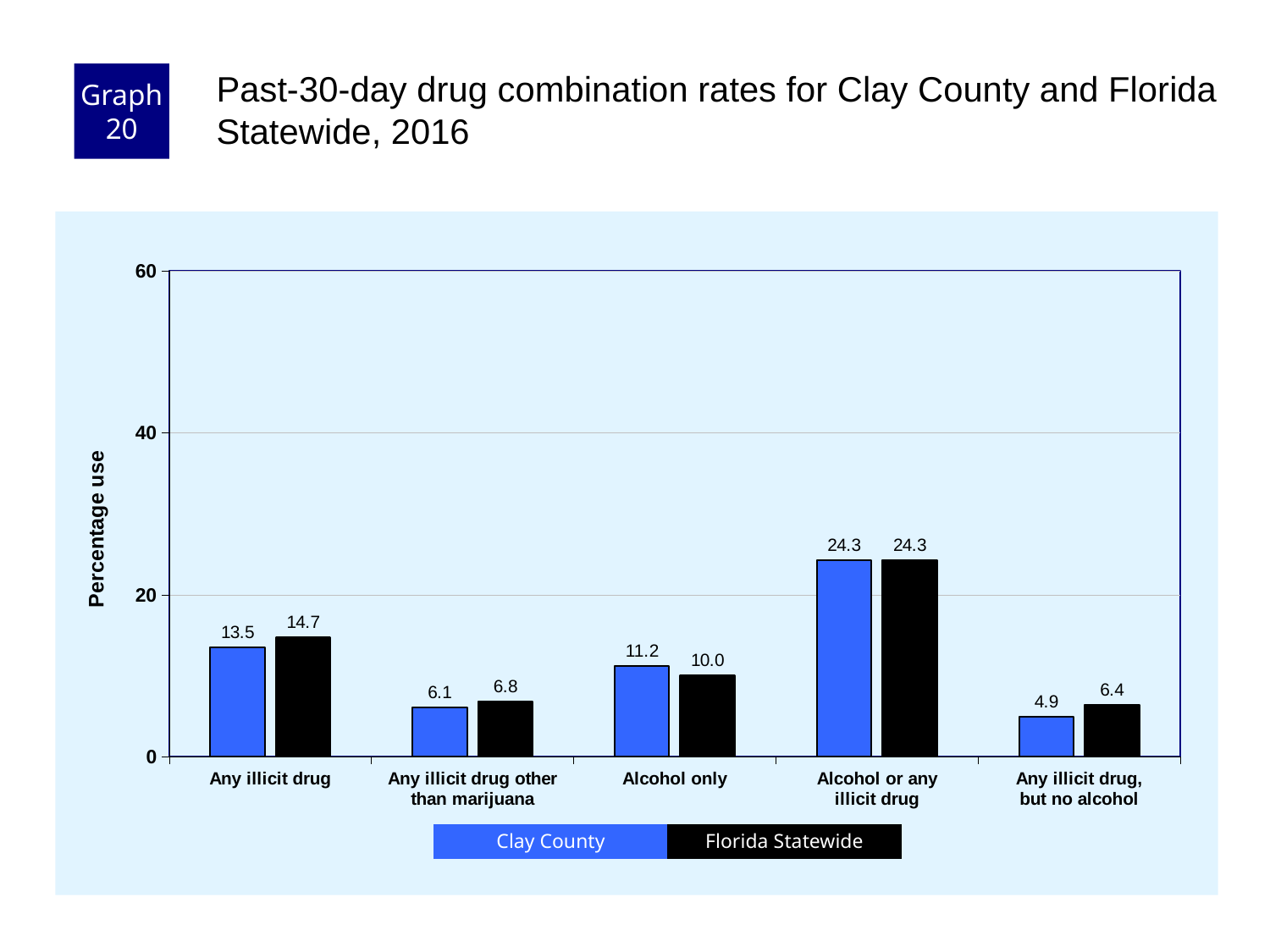
Is the Clay County value for Alcohol or any illicit drug greater or less than 20? greater What is the Florida Statewide value for Any illicit drug, but no alcohol? 6.4 What is the Florida Statewide value for Alcohol only? 10.0 How many categories are shown on the x axis? 5 Which category has the highest Clay County value? Alcohol or any illicit drug What kind of chart is shown? bar chart How many series does the legend list? 2 What is the Clay County value for Any illicit drug? 13.5 Which category has the lowest Florida Statewide value? Any illicit drug, but no alcohol What is the difference between the Florida Statewide and Clay County values for Any illicit drug? 1.2 Which is larger for Alcohol only: Clay County or Florida Statewide? Clay County What is the label of the y axis? Percentage use